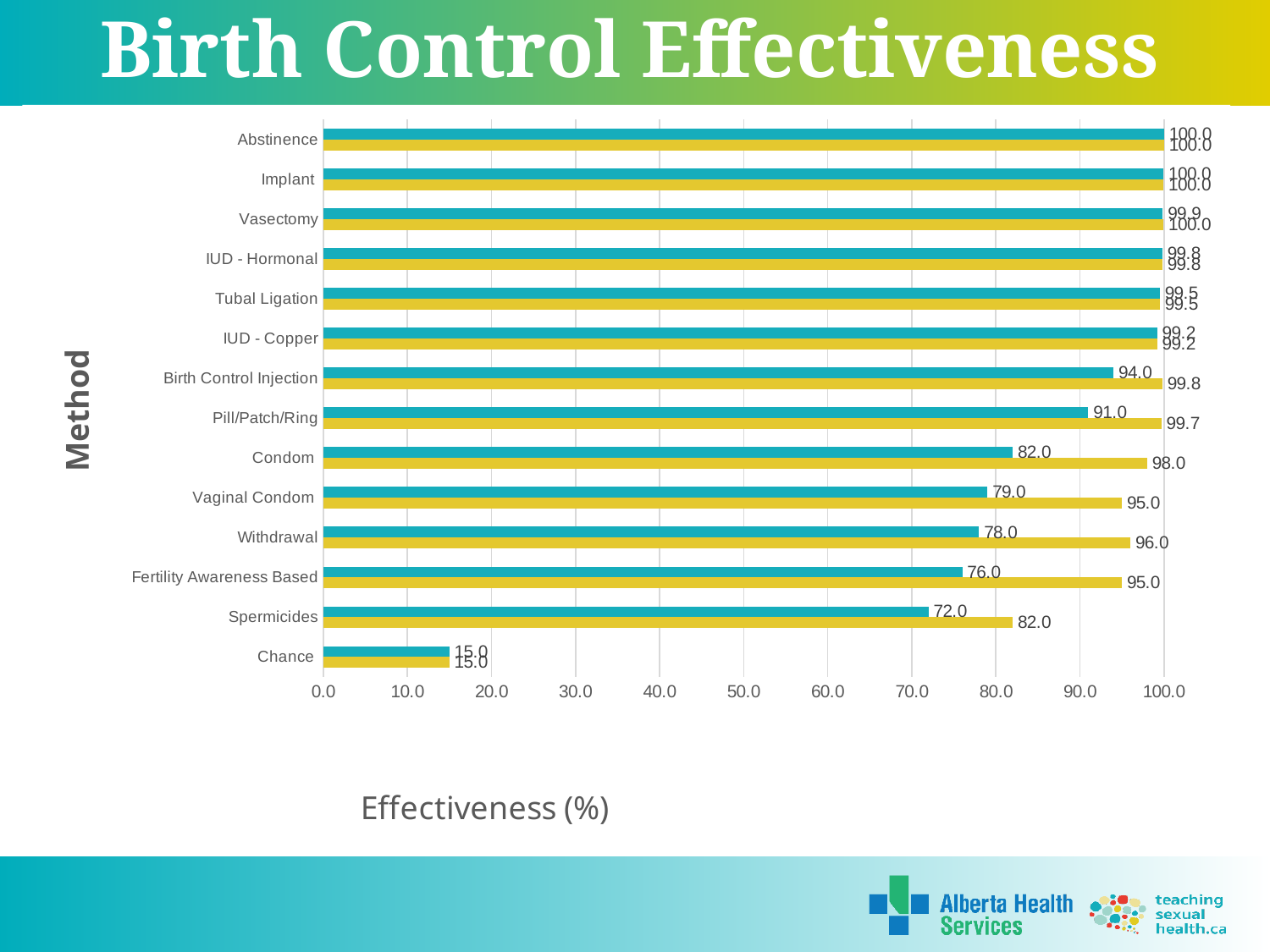
What type of chart is shown on the slide? bar chart What is the value of the teal bar for Birth Control Injection? 94.0 Which method has the lowest effectiveness on the chart? Chance Which has a larger teal bar value, Withdrawal or Fertility Awareness Based? Withdrawal What is the value of the teal bar for Condom? 82.0 What is the value of the yellow bar for Spermicides? 82.0 How many birth control methods are listed on the chart? 14 What is the difference between the yellow bar and the teal bar for Spermicides? 10.0 What is the label on the horizontal axis of the chart? Effectiveness (%) What is the value of the yellow bar for Pill/Patch/Ring? 99.7 What is the difference between the yellow bar and the teal bar for Condom? 16.0 Is the teal bar value for Spermicides greater or less than 70.0? greater